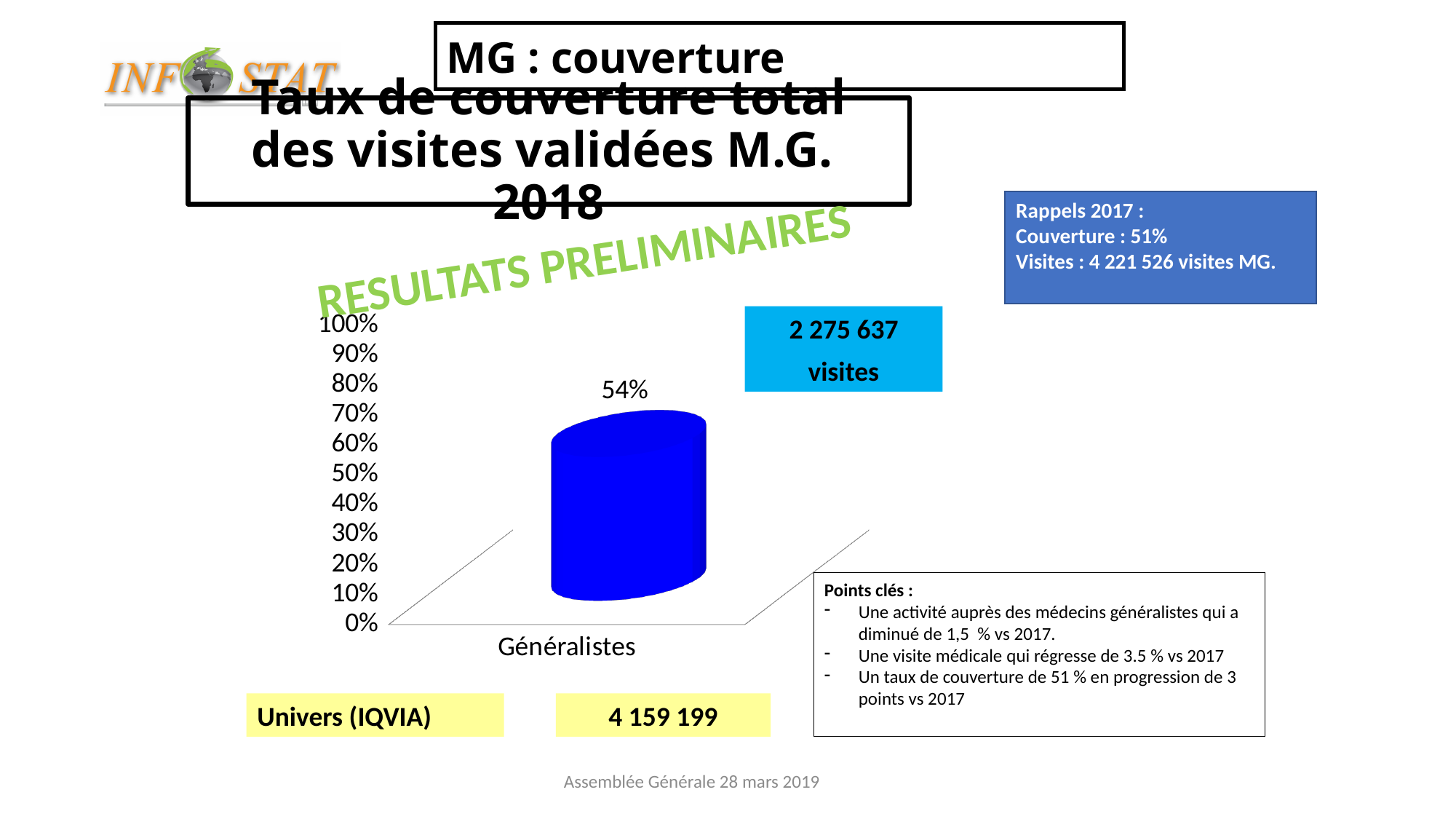
How many categories are plotted on the x axis of the chart? 1 What kind of chart is shown on the slide? bar chart What is the value shown for Généralistes in the chart? 54% Is the value for Généralistes greater or less than 70%? less Is the value for Généralistes greater or less than 60%? less What is the label of the single category on the x axis of the chart? Généralistes Is the value for Généralistes greater or less than 50%? greater What is the highest value shown on the chart's vertical axis? 100%